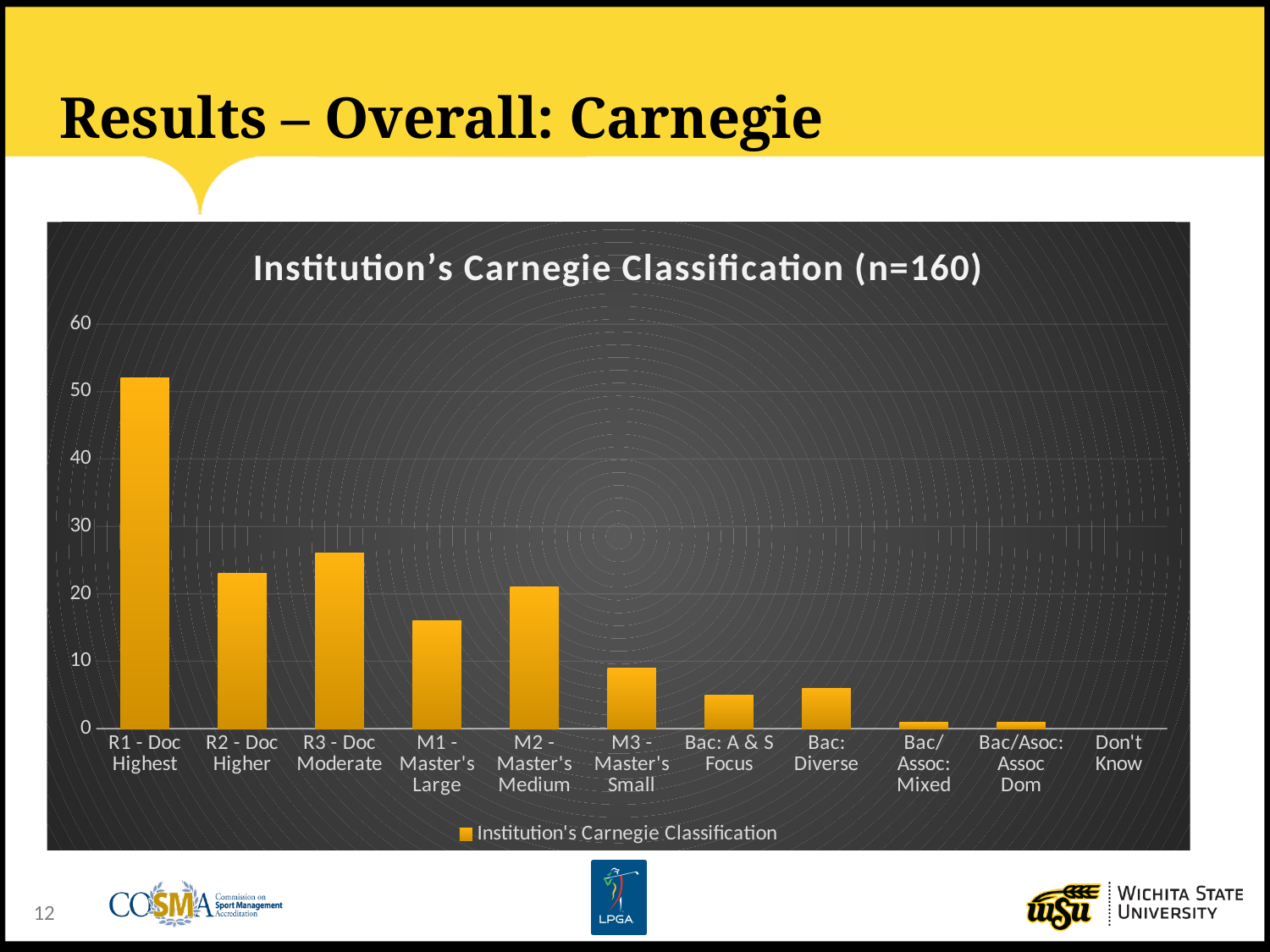
Which is larger, the value for M2 - Master's Medium or the value for M1 - Master's Large? M2 - Master's Medium How many categories are shown on the x axis of the chart? 11 How many series does the chart's legend list? 1 Which category has the highest value in the chart? R1 - Doc Highest What type of chart is shown on the slide? bar chart Is the value for M1 - Master's Large greater or less than 20? less Is the value for R3 - Doc Moderate greater or less than 20? greater What is the title of the chart? Institution's Carnegie Classification (n=160) Is the value for R1 - Doc Highest greater or less than 50? greater Which is larger, the value for R1 - Doc Highest or the value for R2 - Doc Higher? R1 - Doc Highest